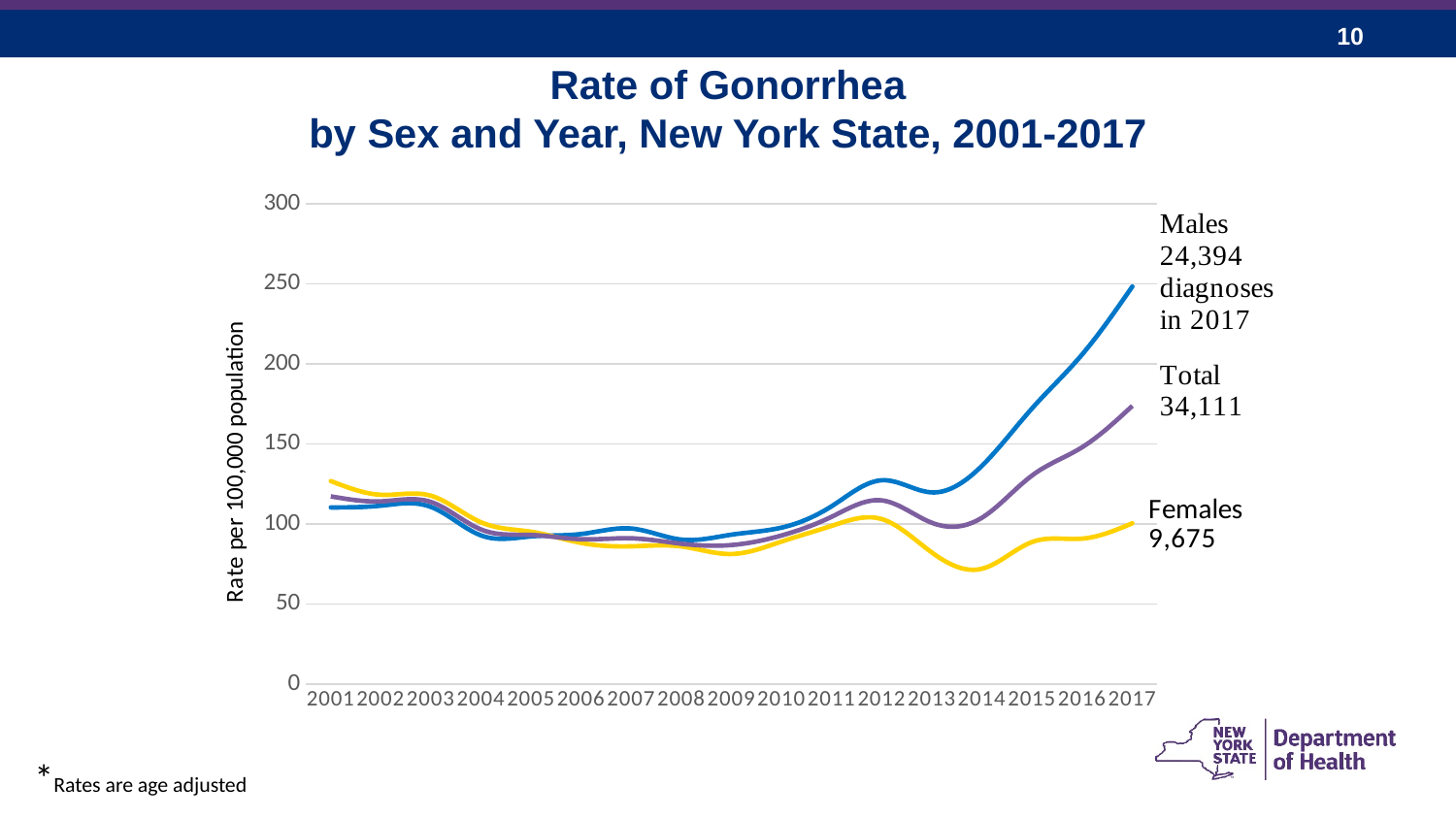
Is the rate for Males in 2017 greater or less than 200? greater What total number of diagnoses is noted on the chart? 34,111 How many series are plotted on the chart? 3 Is the rate for Females in 2014 greater or less than 100? less What is the label on the y axis? Rate per 100,000 population How many years are shown along the x axis? 17 How many gonorrhea diagnoses among males in 2017 are noted on the chart? 24,394 Which series has the highest rate in 2017? Males Which series has the lowest rate in 2017? Females How many gonorrhea diagnoses among females in 2017 are noted on the chart? 9,675 What kind of chart is shown on the slide? line chart What is the difference between the number of male diagnoses and female diagnoses noted for 2017? 14,719